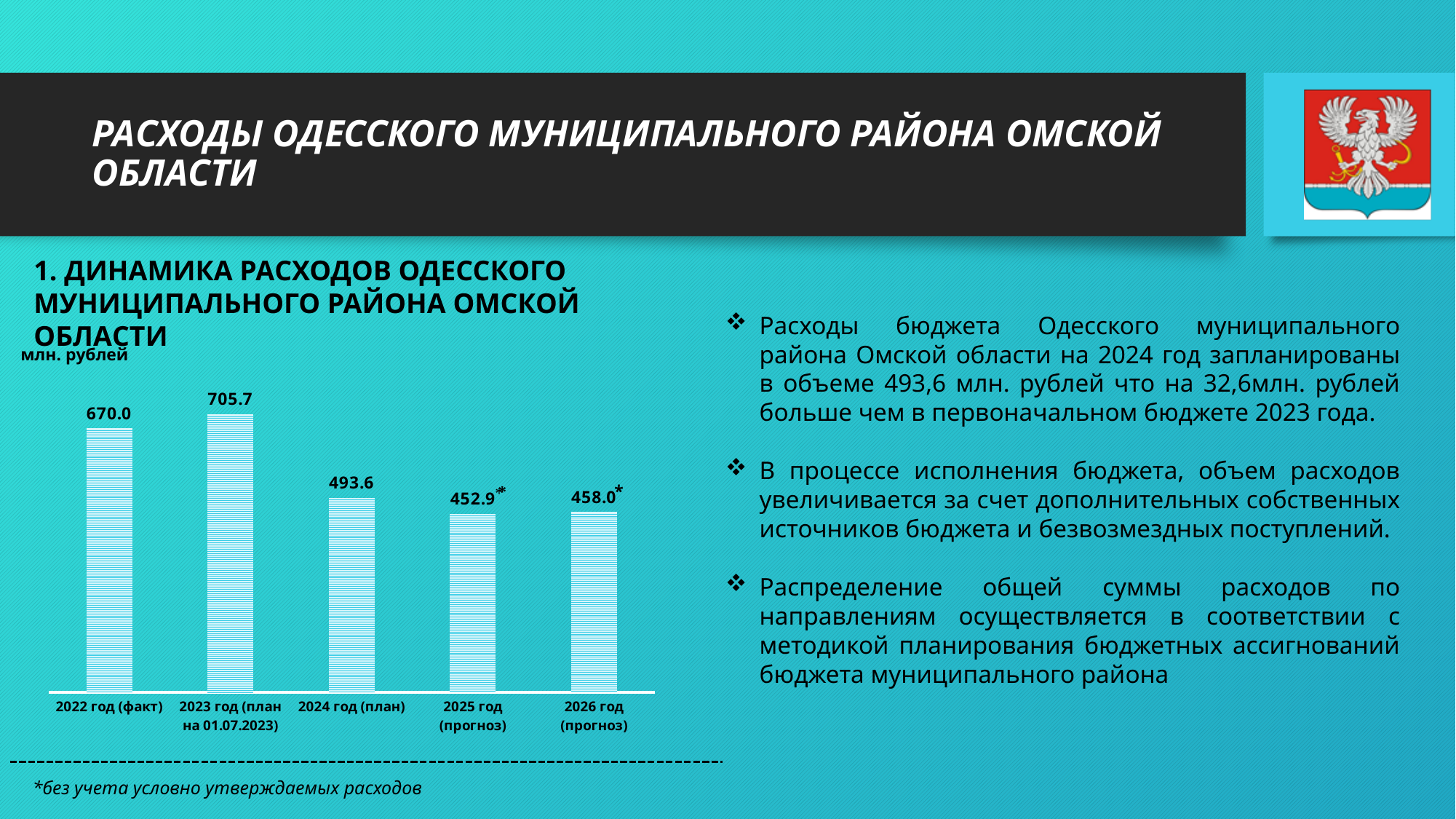
What unit is indicated for the values in the chart? млн. рублей What is the value for 2026 год (прогноз)? 458.0 What is the value for 2024 год (план)? 493.6 What is the value for 2022 год (факт)? 670.0 Which is larger, the value for 2022 год (факт) or the value for 2024 год (план)? 2022 год (факт) What is the value for 2025 год (прогноз)? 452.9 How many categories are shown on the x axis of the chart? 5 What is the difference between the values for 2023 год (план на 01.07.2023) and 2024 год (план)? 212.1 Which category has the lowest value? 2025 год (прогноз) Which category has the highest value? 2023 год (план на 01.07.2023) What type of chart is shown on the slide? bar chart What is the value for 2023 год (план на 01.07.2023)? 705.7